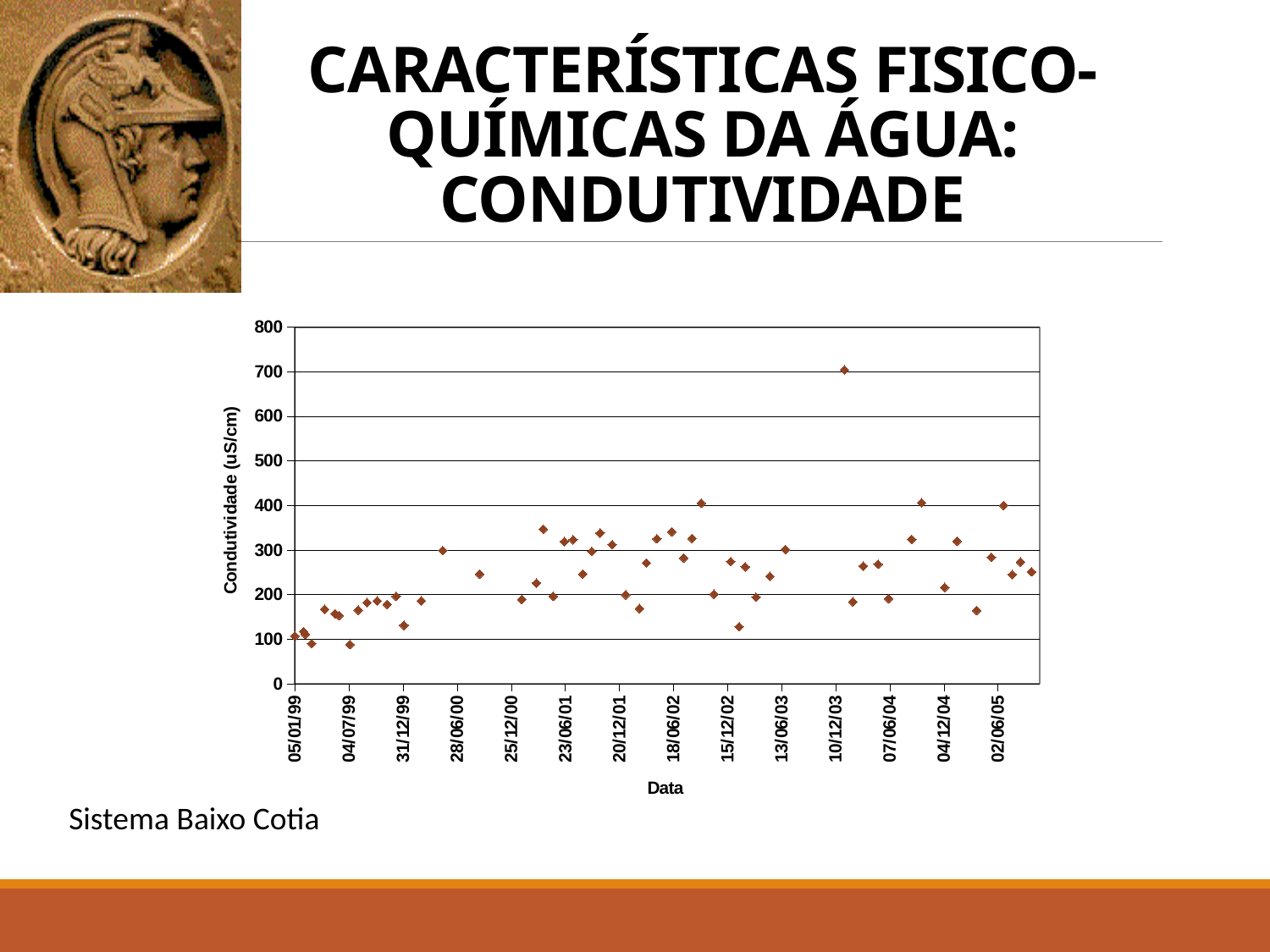
How many date labels are shown on the x axis of the chart? 14 What is the highest value shown on the y axis of the chart? 800 What is the last date label on the x axis of the chart? 02/06/05 What is the label of the x axis of the chart? Data Is the conductivity value plotted at 15/12/02 greater or less than 300? less What kind of chart is shown on the slide? scatter chart What is the first date label on the x axis of the chart? 05/01/99 Near which x-axis date label does the highest conductivity value occur? 10/12/03 Is the highest conductivity value plotted on the chart greater or less than 600? greater Do the conductivity values generally rise or fall from 1999 to 2005? rise Is the conductivity value plotted at 18/06/02 greater or less than 300? greater What is the label of the y axis of the chart? Condutividade (uS/cm)